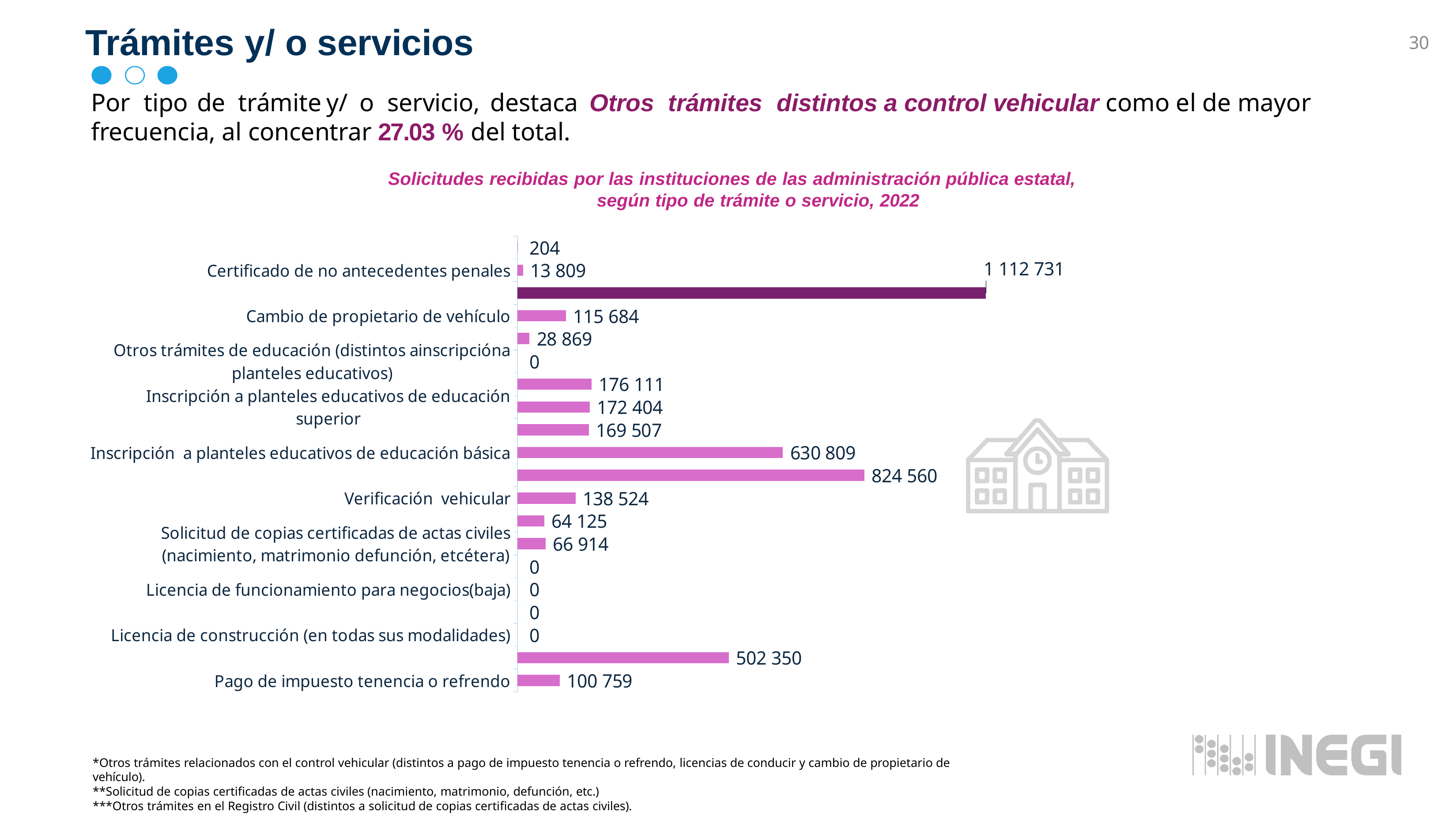
What is the difference between the values for Verificación vehicular and Cambio de propietario de vehículo? 22 840 Which is larger, the value for Inscripción a planteles educativos de educación básica or the value for Verificación vehicular? Inscripción a planteles educativos de educación básica How many bars have a data label of 0 in the chart? 5 How many data labels are shown in the chart? 20 What is the value for Verificación vehicular? 138 524 What is the value for Certificado de no antecedentes penales? 13 809 What is the value for Cambio de propietario de vehículo? 115 684 What is the highest value shown in the chart? 1 112 731 What year does the chart title refer to? 2022 What is the value for Pago de impuesto tenencia o refrendo? 100 759 What is the value for Inscripción a planteles educativos de educación básica? 630 809 What type of chart is shown on the slide? bar chart